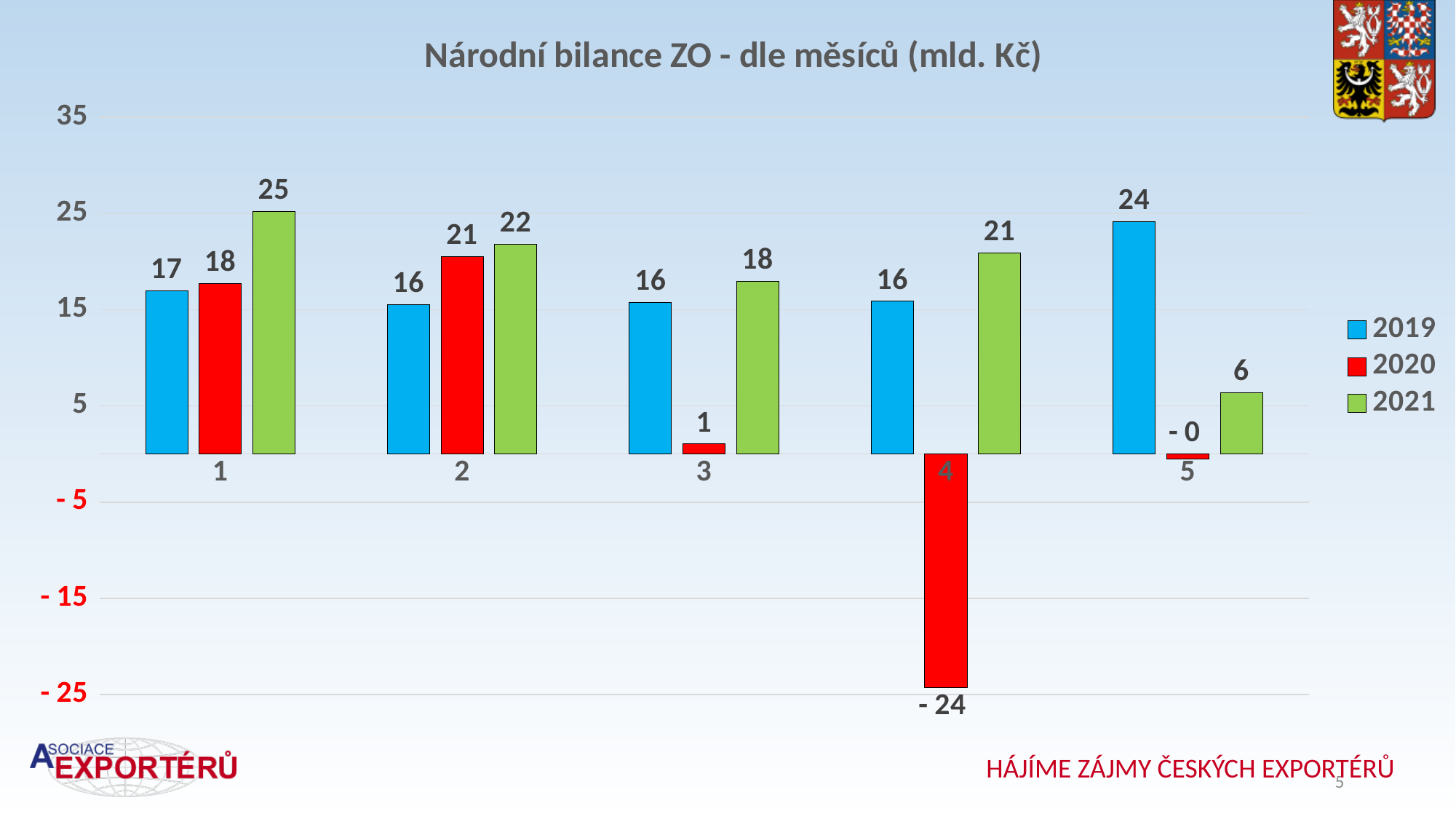
What is the value for 2021 in month 1? 25 How many months (categories) are shown on the x axis? 5 Which month has the highest value for the 2019 series? 5 What is the title of the chart? Národní bilance ZO - dle měsíců (mld. Kč) How many series does the legend list? 3 What is the value for 2020 in month 4? - 24 What is the value for 2019 in month 5? 24 Which is larger in month 2: the 2020 value or the 2021 value? 2021 What is the difference between the 2021 and 2019 values in month 1? 8 Which month has the lowest value for the 2020 series? 4 What kind of chart is shown on the slide? bar chart What is the value for 2020 in month 3? 1